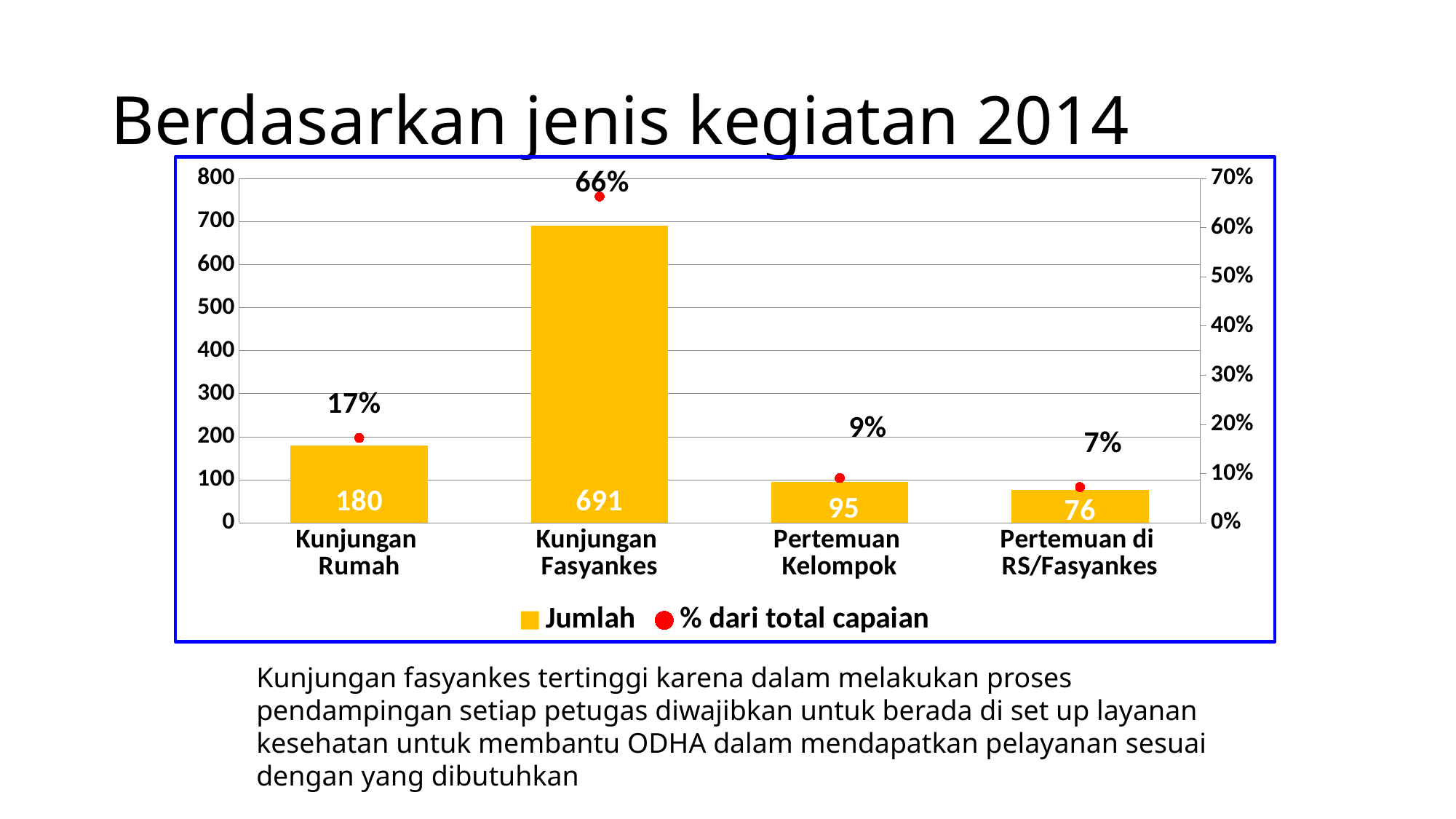
What is the Jumlah value for Kunjungan Fasyankes? 691 How many categories are shown on the x axis? 4 Which category has the lowest Jumlah value? Pertemuan di RS/Fasyankes Which category has the highest Jumlah value? Kunjungan Fasyankes What is the title of the slide? Berdasarkan jenis kegiatan 2014 What kind of chart is used to show the Jumlah series? Bar chart What is the % dari total capaian for Pertemuan di RS/Fasyankes? 7% What is the Jumlah value for Kunjungan Rumah? 180 What is the % dari total capaian for Pertemuan Kelompok? 9% Which has a larger Jumlah value, Pertemuan Kelompok or Pertemuan di RS/Fasyankes? Pertemuan Kelompok How many series does the legend list? 2 What is the difference in Jumlah between Kunjungan Fasyankes and Kunjungan Rumah? 511